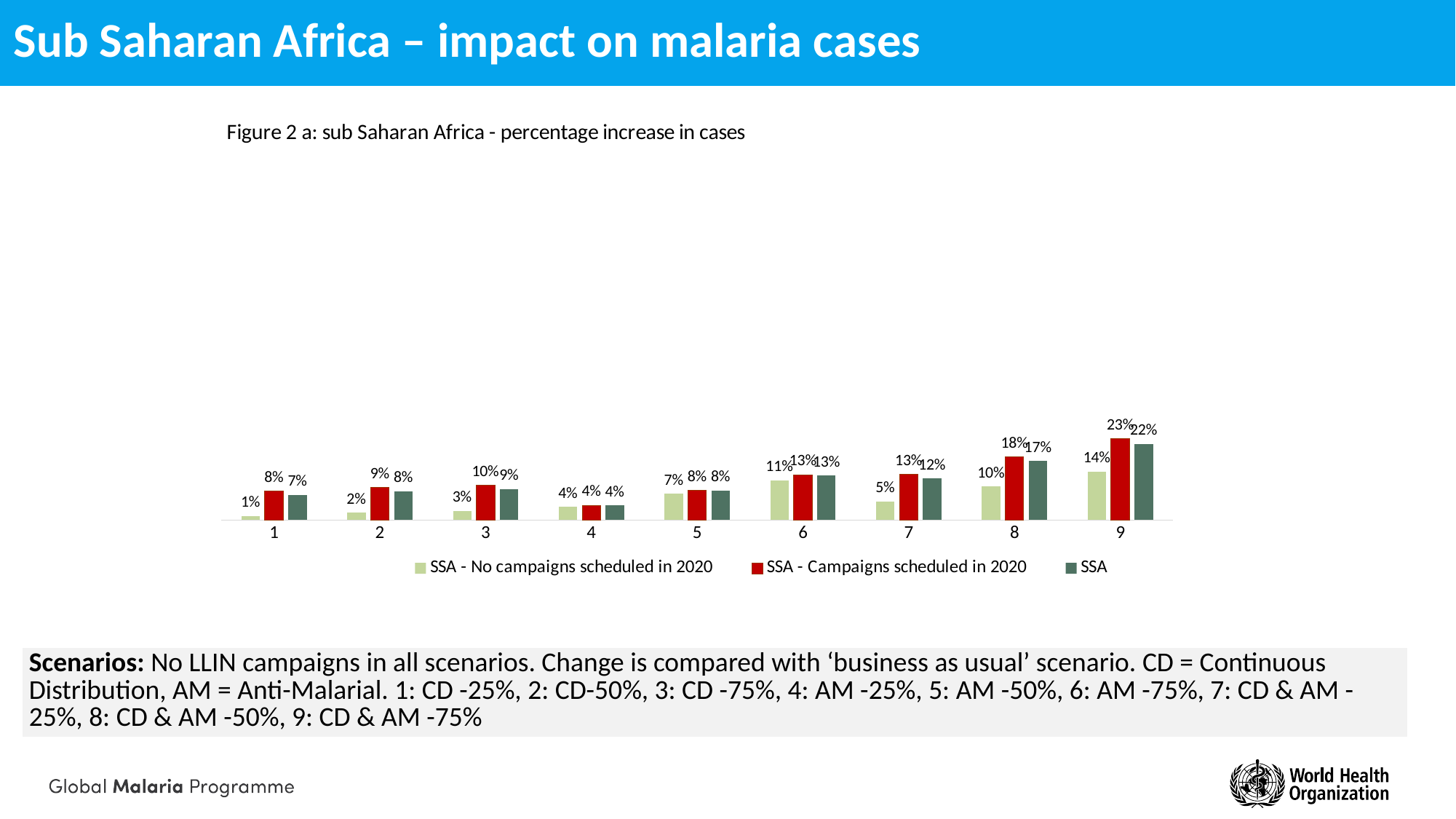
Which scenario has the highest value in the 'SSA - Campaigns scheduled in 2020' series? 9 What is the value for scenario 1 in the 'SSA - No campaigns scheduled in 2020' series? 1% For scenario 6, which is larger: the 'SSA - No campaigns scheduled in 2020' value or the 'SSA' value? SSA Does the 'SSA' series value generally rise or fall from scenario 1 to scenario 3? Rise What is the value for scenario 8 in the 'SSA' series? 17% What type of chart is shown in Figure 2 a? Bar chart How many series does the legend list? 3 What is the difference between the 'SSA - Campaigns scheduled in 2020' and 'SSA - No campaigns scheduled in 2020' values for scenario 7? 8% What is the value for scenario 9 in the 'SSA - Campaigns scheduled in 2020' series? 23% What is the title of the figure shown on the slide? Figure 2 a: sub Saharan Africa - percentage increase in cases How many scenario categories are shown on the x axis? 9 Which scenario has the lowest value in the 'SSA - No campaigns scheduled in 2020' series? 1